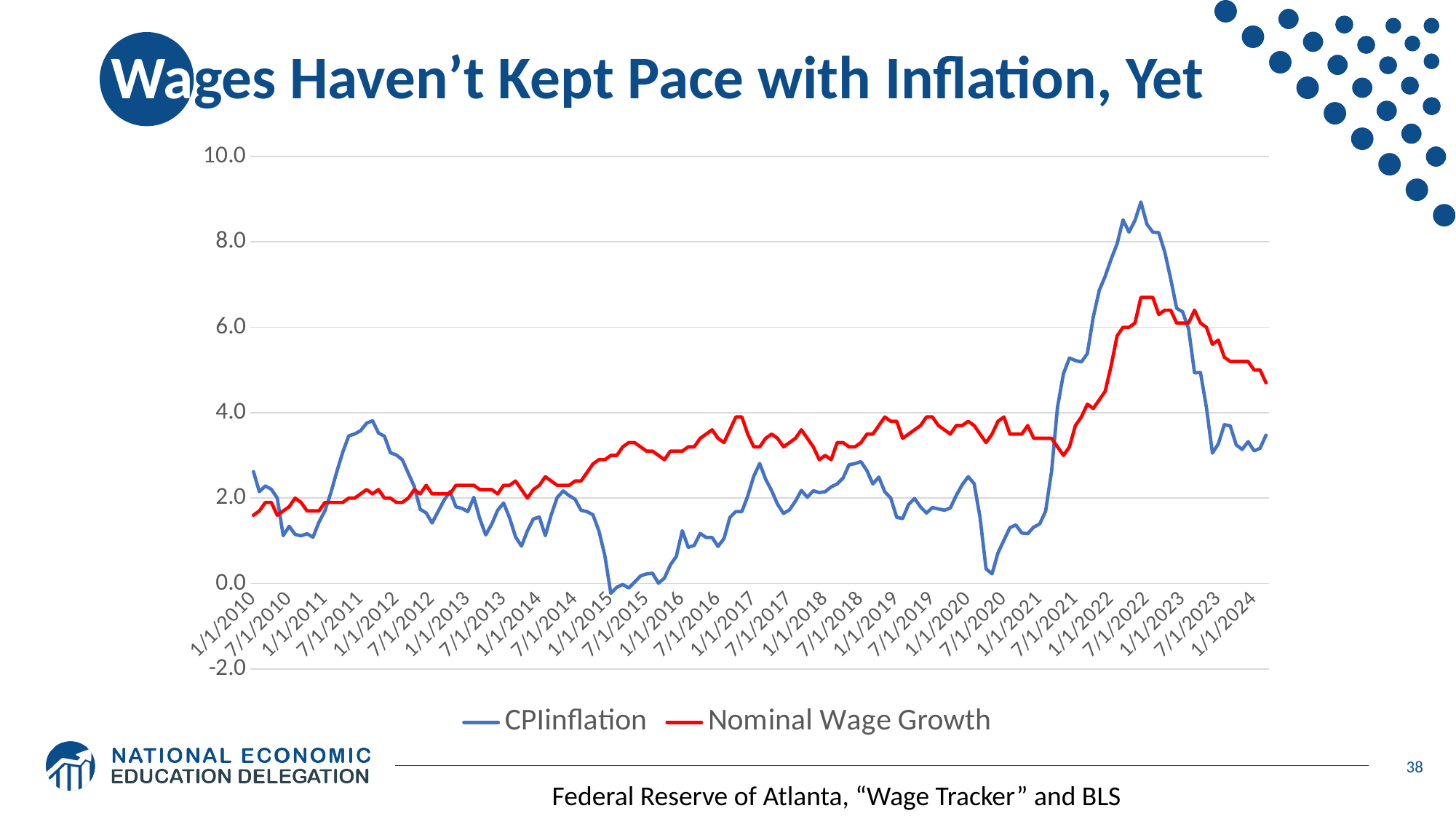
At 1/1/2024, which series has the higher value, CPI inflation or Nominal Wage Growth? Nominal Wage Growth Does Nominal Wage Growth rise or fall between 7/1/2022 and 1/1/2024? fall Which series reaches the lowest value on the chart? CPI inflation Is the value of Nominal Wage Growth at 1/1/2024 greater or less than 4.0? greater Is the peak value of CPI inflation around 7/1/2022 greater or less than 8.0? greater Around 7/1/2022, which series has the higher value, CPI inflation or Nominal Wage Growth? CPI inflation Which series is drawn in red? Nominal Wage Growth What is the title of the slide's chart? Wages Haven't Kept Pace with Inflation, Yet What kind of chart is shown on the slide? Line chart How many series does the legend list? 2 Which series reaches the highest peak on the chart? CPI inflation Is the peak value of Nominal Wage Growth around 7/1/2022 greater or less than 6.0? greater